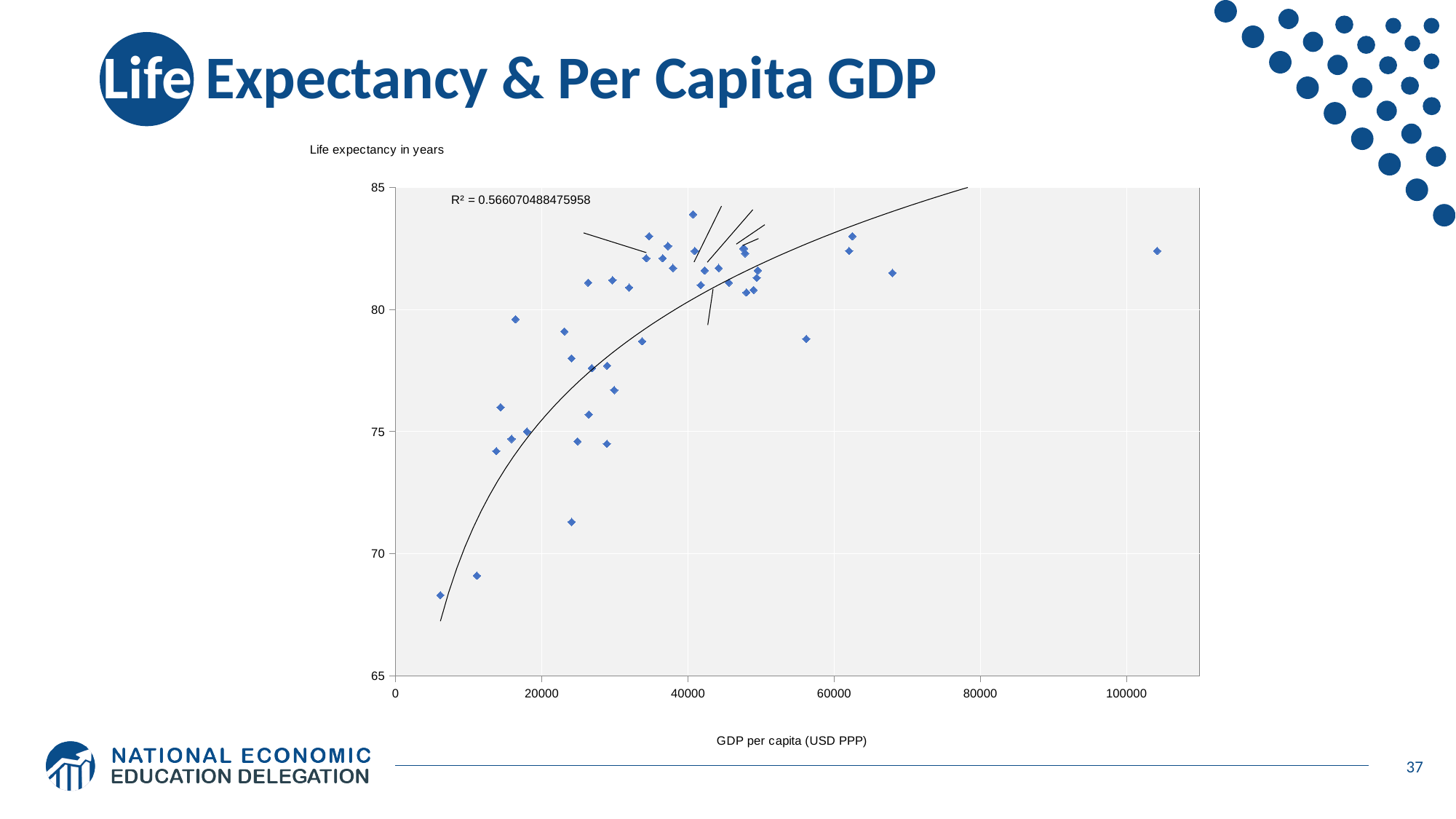
Is the life expectancy of the point with the highest GDP per capita greater or less than 80? greater What is the highest value shown on the vertical axis? 85 Is the GDP per capita of the point with the highest life expectancy greater or less than 60000? less What is the lowest value shown on the vertical axis? 65 What is the label of the vertical axis? Life expectancy in years What kind of chart is shown on the slide? scatter chart Is the GDP per capita of the rightmost point greater or less than 100000? greater What is the label of the horizontal axis? GDP per capita (USD PPP) What R² value is printed on the chart? R² = 0.566070488475958 As GDP per capita increases along the x axis, does the fitted trend line rise or fall? rise